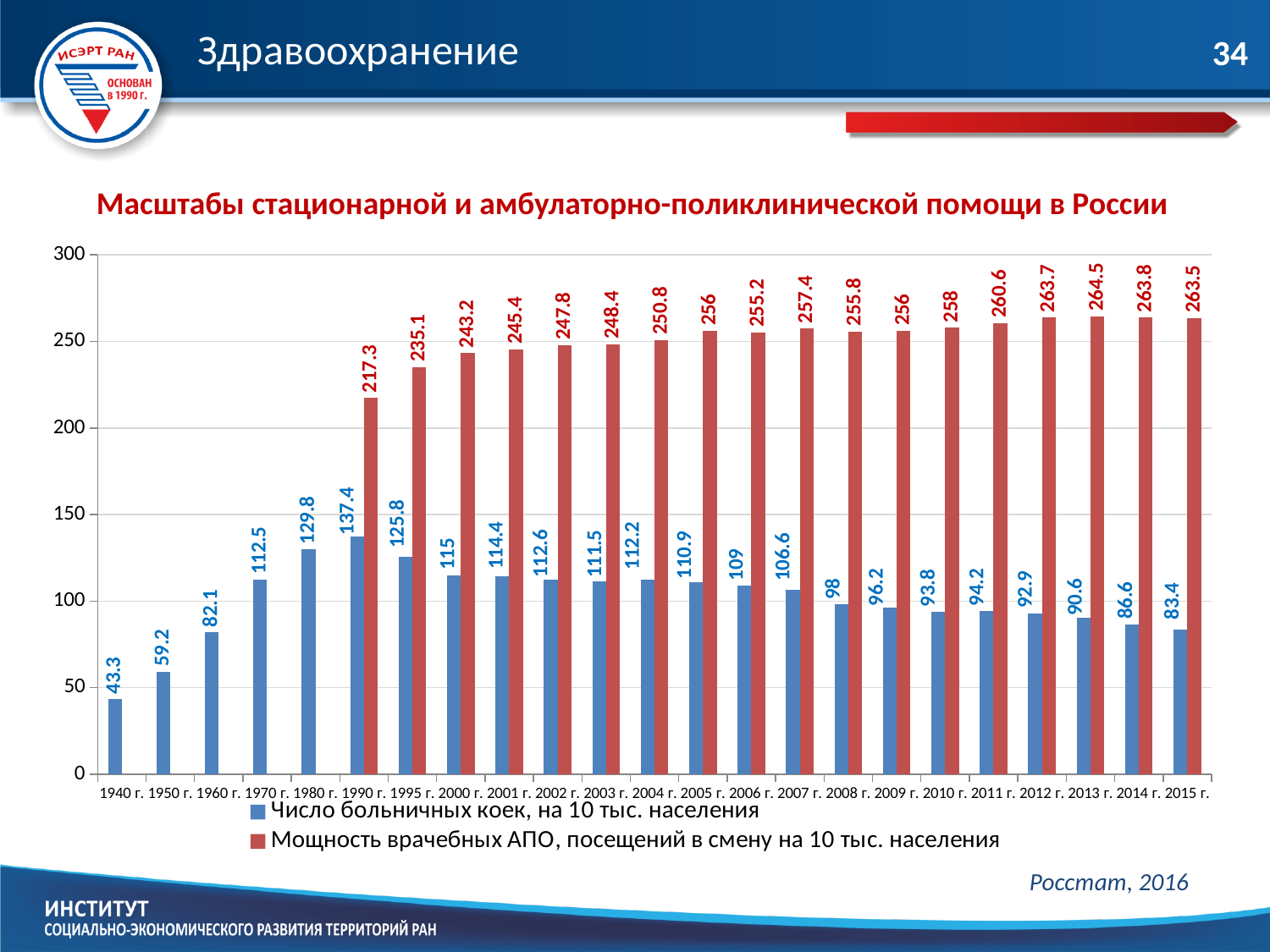
What type of chart is shown on the slide? Bar chart What is the value of 'Число больничных коек, на 10 тыс. населения' for 1940 г.? 43.3 In which year is 'Число больничных коек, на 10 тыс. населения' lowest? 1940 г. How many series does the legend list? 2 In which year is 'Число больничных коек, на 10 тыс. населения' highest? 1990 г. What is the difference between 'Мощность врачебных АПО' and 'Число больничных коек' in 1990 г.? 79.9 Which is larger in 2015 г.: 'Число больничных коек' or 'Мощность врачебных АПО'? Мощность врачебных АПО What is the title of the chart? Масштабы стационарной и амбулаторно-поликлинической помощи в России How many years are shown on the x axis? 23 Does 'Число больничных коек, на 10 тыс. населения' rise or fall from 1990 г. to 2015 г.? Fall In which year is 'Мощность врачебных АПО, посещений в смену на 10 тыс. населения' highest? 2013 г. What is the value of 'Мощность врачебных АПО, посещений в смену на 10 тыс. населения' for 2015 г.? 263.5